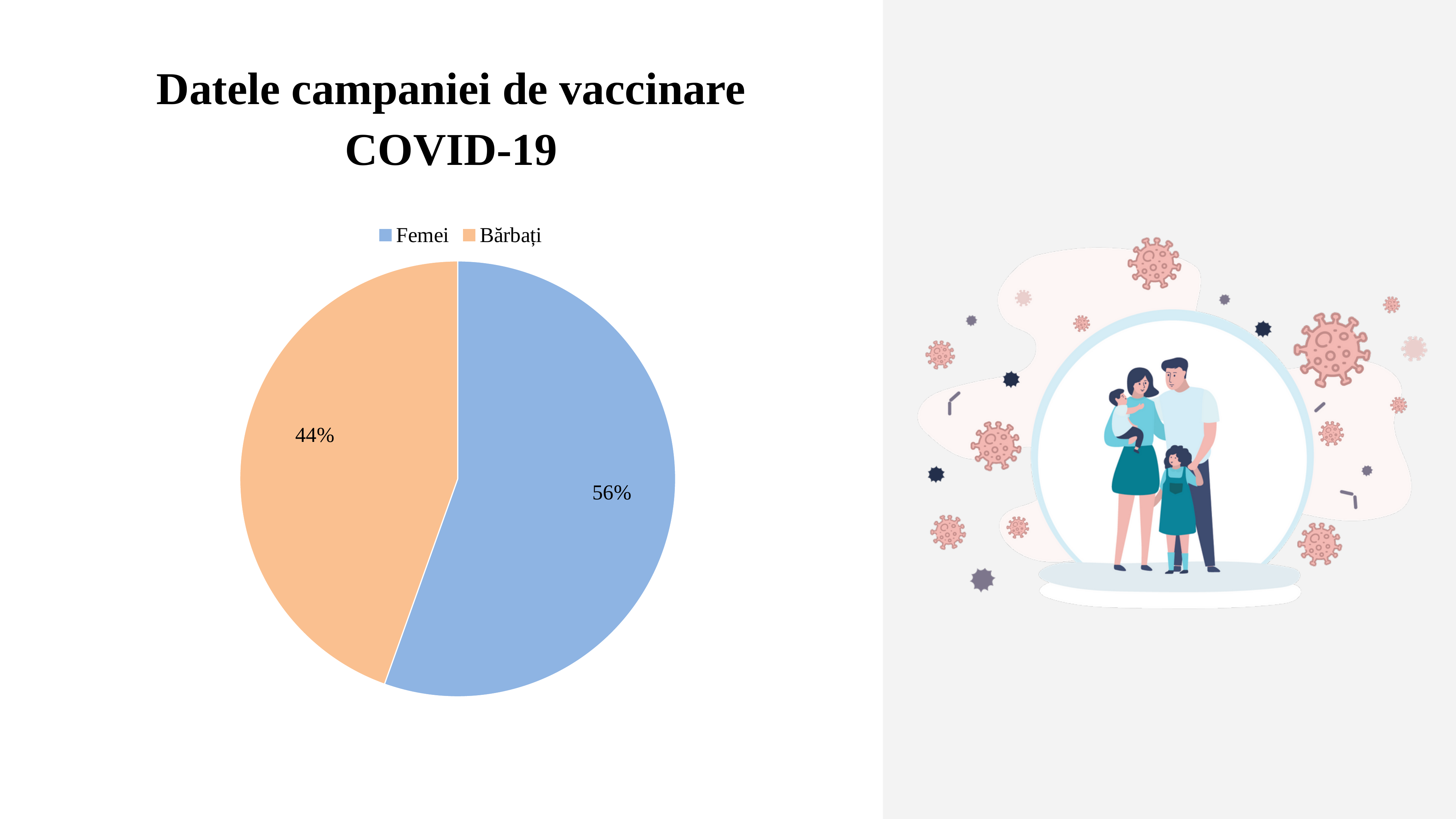
Which category has the smallest slice of the pie? Bărbați What share of the pie does Bărbați represent? 44% What colour is the Femei slice? blue What kind of chart is shown on the slide? pie chart Which category has the largest slice of the pie? Femei What share of the pie does Femei represent? 56% How many slices does the pie chart have? 2 How many entries does the legend list? 2 What is the difference in percentage points between the Femei and Bărbați slices? 12% What colour is the Bărbați slice? orange Which is larger, the Femei slice or the Bărbați slice? Femei